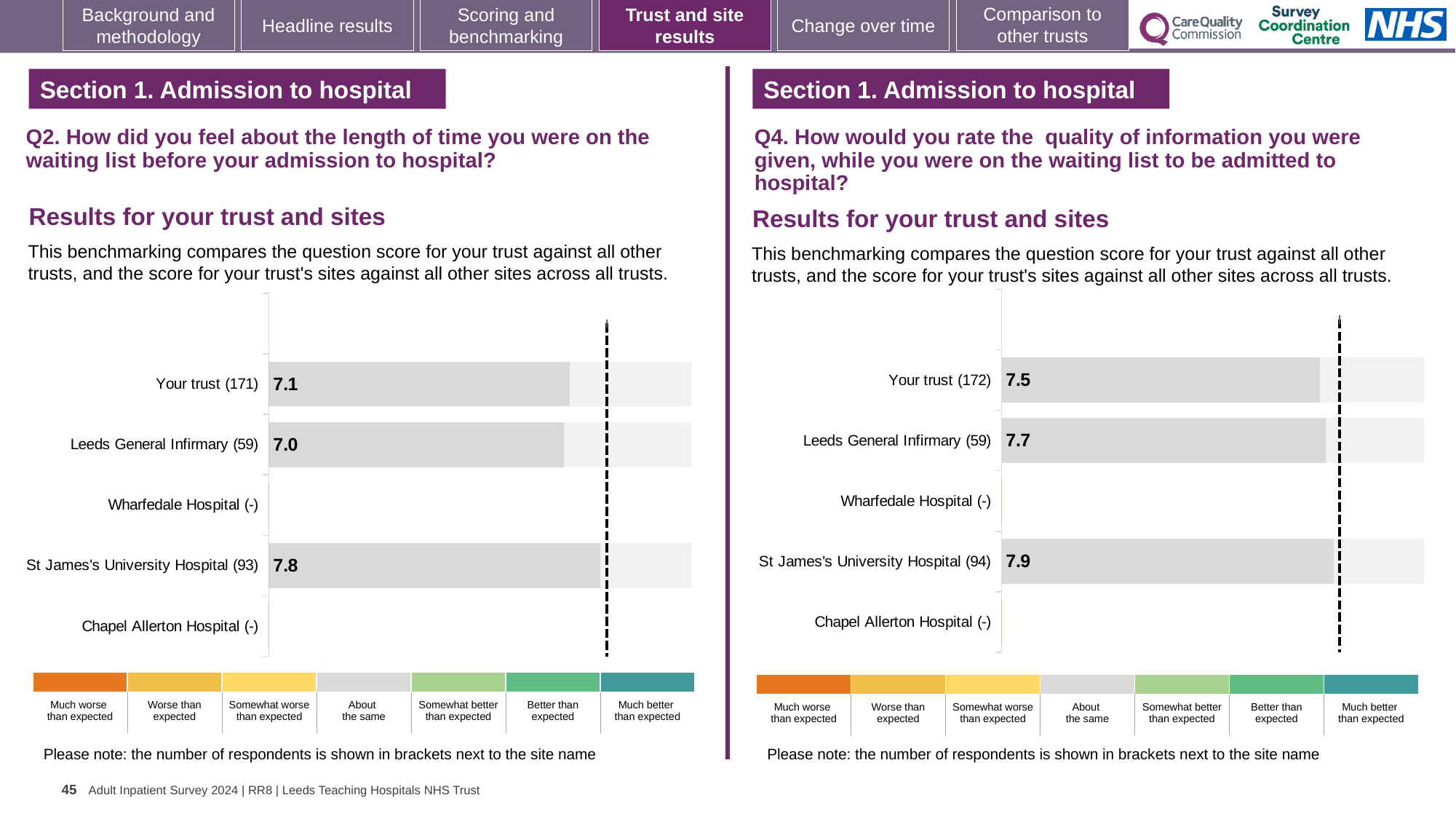
What kind of chart is used on the right (Q4)? Bar chart On the left chart (Q2), what is the score for St James's University Hospital? 7.8 On the left chart (Q2), how many respondents are shown in brackets for St James's University Hospital? 93 On the right chart (Q4), what is the difference between the scores for St James's University Hospital and Your trust? 0.4 On the left chart (Q2), what is the score for Your trust? 7.1 On the left chart (Q2), which site has the highest score? St James's University Hospital On the right chart (Q4), what is the score for Leeds General Infirmary? 7.7 How many categories (rows) are listed on the left chart (Q2)? 5 On the right chart (Q4), which has the larger score, Your trust or Leeds General Infirmary? Leeds General Infirmary On the right chart (Q4), what is the score for Your trust? 7.5 On the right chart (Q4), which site has the highest score? St James's University Hospital On the left chart (Q2), what is the difference between the scores for St James's University Hospital and Leeds General Infirmary? 0.8